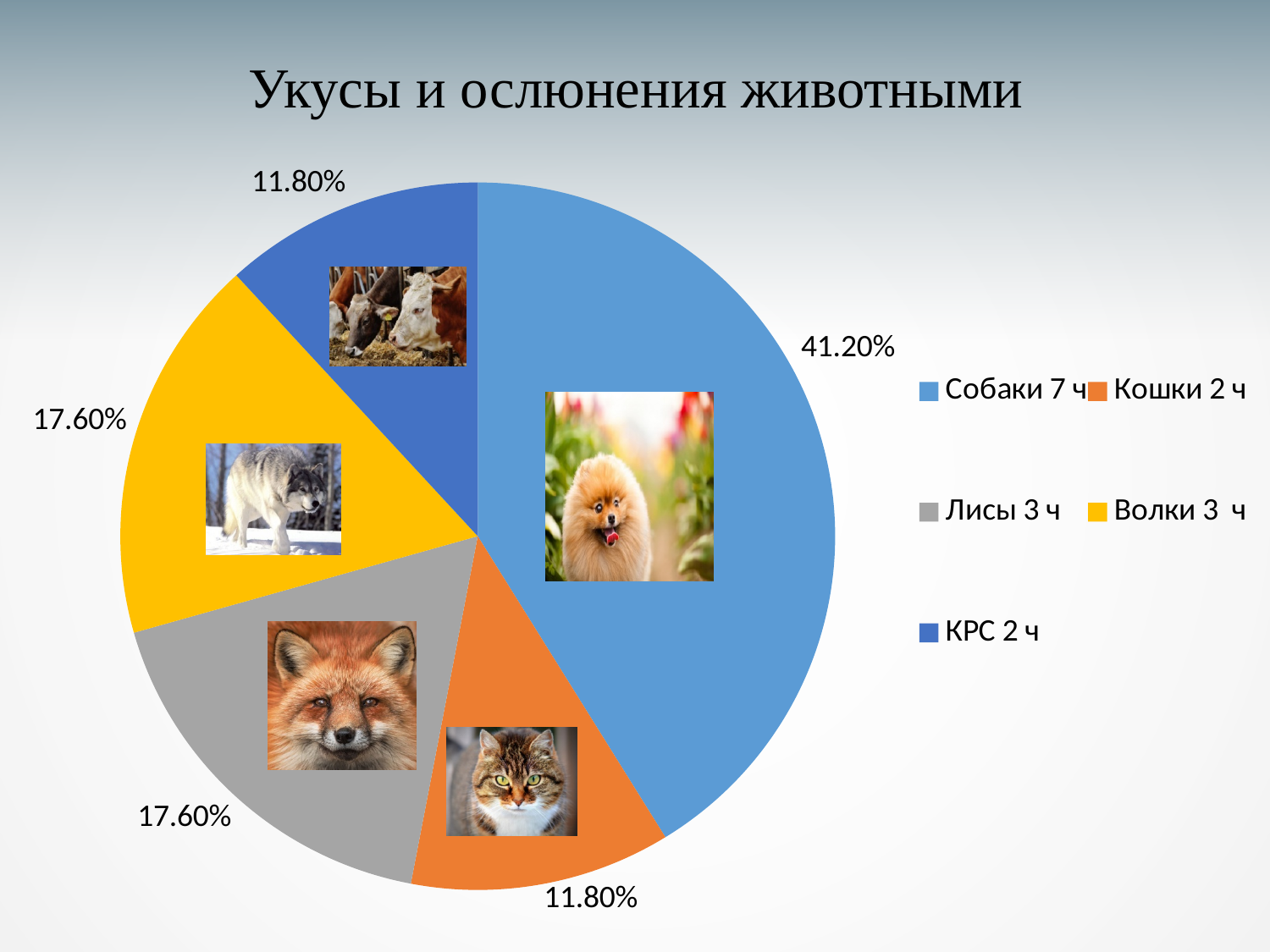
What percentage is shown for Волки 3 ч? 17.60% What percentage is shown for Кошки 2 ч? 11.80% What percentage is shown for Лисы 3 ч? 17.60% What percentage is shown for КРС 2 ч? 11.80% Which is larger, the slice for Собаки 7 ч or the slice for Лисы 3 ч? Собаки 7 ч Which category has the largest slice of the pie? Собаки 7 ч What share of the pie does the slice for Собаки 7 ч represent? 41.20% What is the difference in percentage points between the Собаки 7 ч slice and the Волки 3 ч slice? 23.60% How many slices does the pie chart have? 5 What type of chart is shown on the slide? pie chart What colour is the slice for Волки 3 ч? yellow What is the title of the chart? Укусы и ослюнения животными